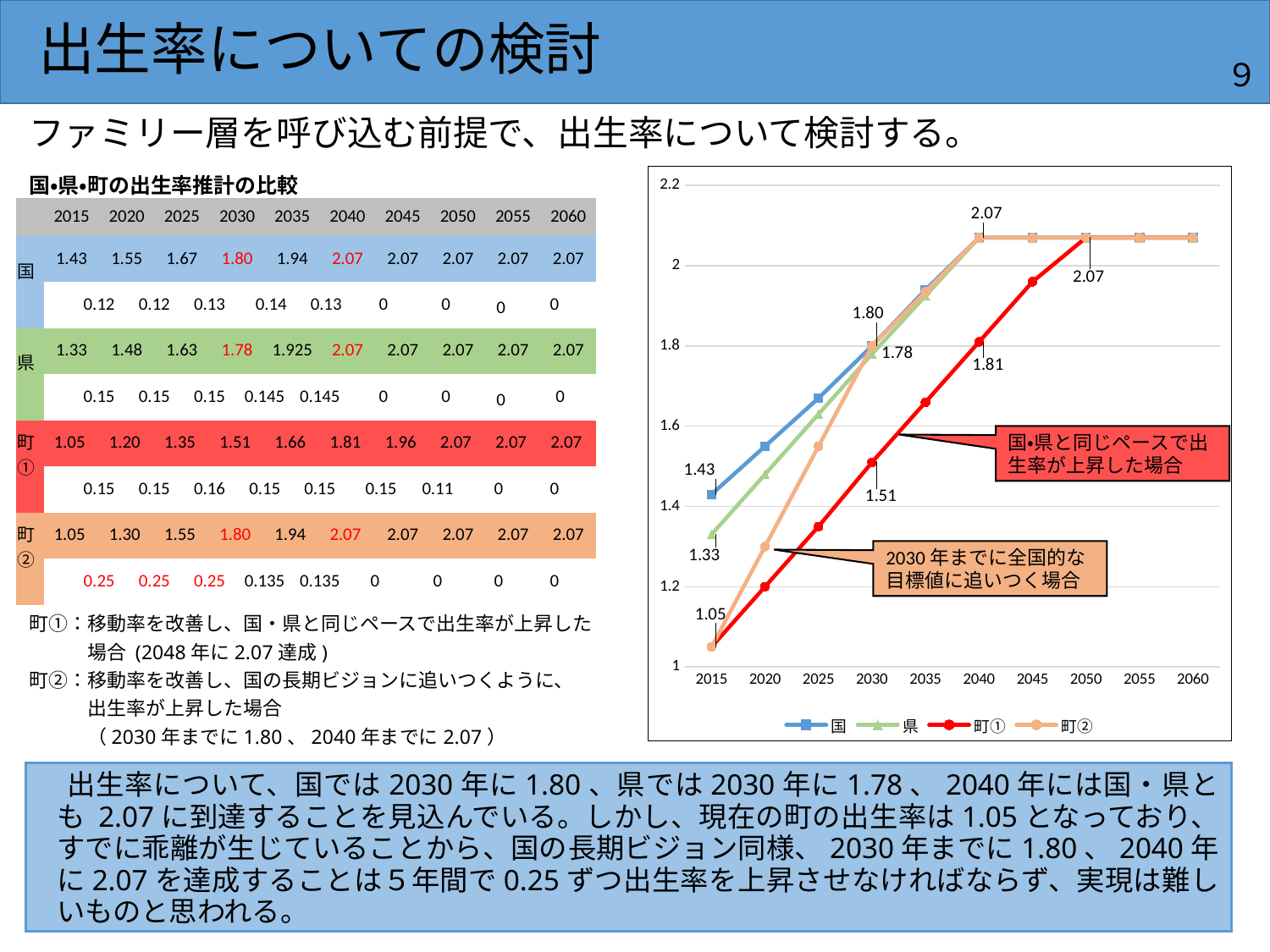
Is the value for 町① in 2020 greater or less than 1.4? less In 2030, which is larger: the value for 国 or the value for 町①? 国 What is the value for 町① in 2040 according to the chart's data label? 1.81 How many years are shown along the x axis of the chart? 10 What is the value for 県 in 2015 according to the chart's data label? 1.33 What is the difference between the 国 value (1.80) and the 県 value (1.78) in 2030? 0.02 Does the 町① line rise or fall from 2015 to 2050? rise How many series does the chart legend list? 4 Which series has the lowest value in 2015? 町①/町② (1.05) What is the value for 町① in 2030 according to the chart's data label? 1.51 What kind of chart is shown on the right side of the slide? line chart What is the value for 国 in 2015 according to the chart's data label? 1.43